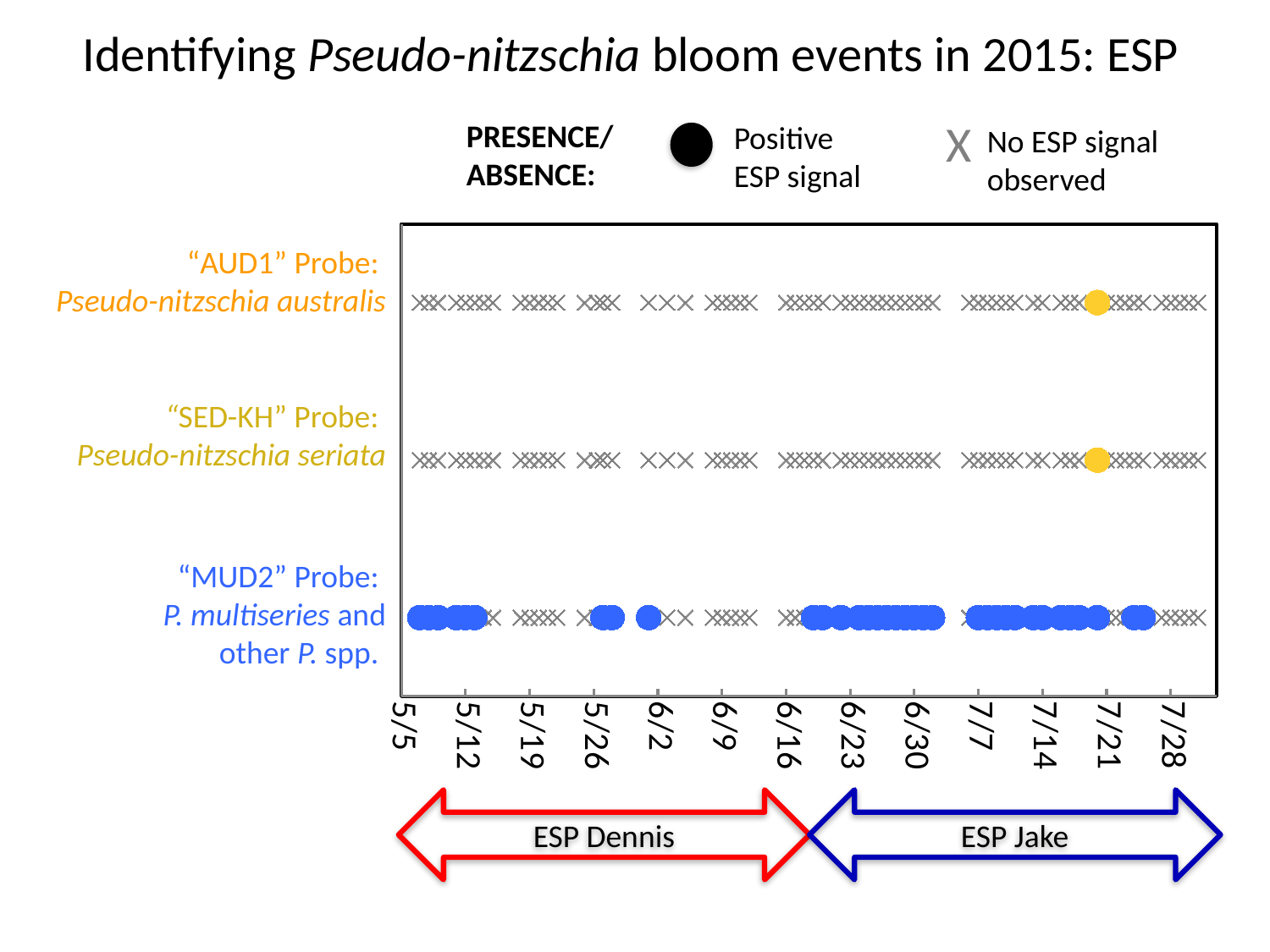
How many date tick labels are shown on the x axis? 13 How many positive ESP signals does the "SED-KH" probe show? 1 How many positive ESP signals does the "AUD1" probe show? 1 Which probe has more positive ESP signals, "SED-KH" or "MUD2"? "MUD2" During which ESP deployment does the "AUD1" probe show its only positive signal? ESP Jake What does a filled circle represent in the chart legend? Positive ESP signal Which ESP deployment covers the earlier part of the record, from 5/5 to about 6/16? ESP Dennis What is the title of the slide? Identifying Pseudo-nitzschia bloom events in 2015: ESP What kind of chart is shown on the slide? A presence/absence dot (scatter) timeline Which probe shows positive ESP signals during the ESP Dennis deployment? "MUD2" Probe Which probe shows the most positive ESP signals? "MUD2" Probe